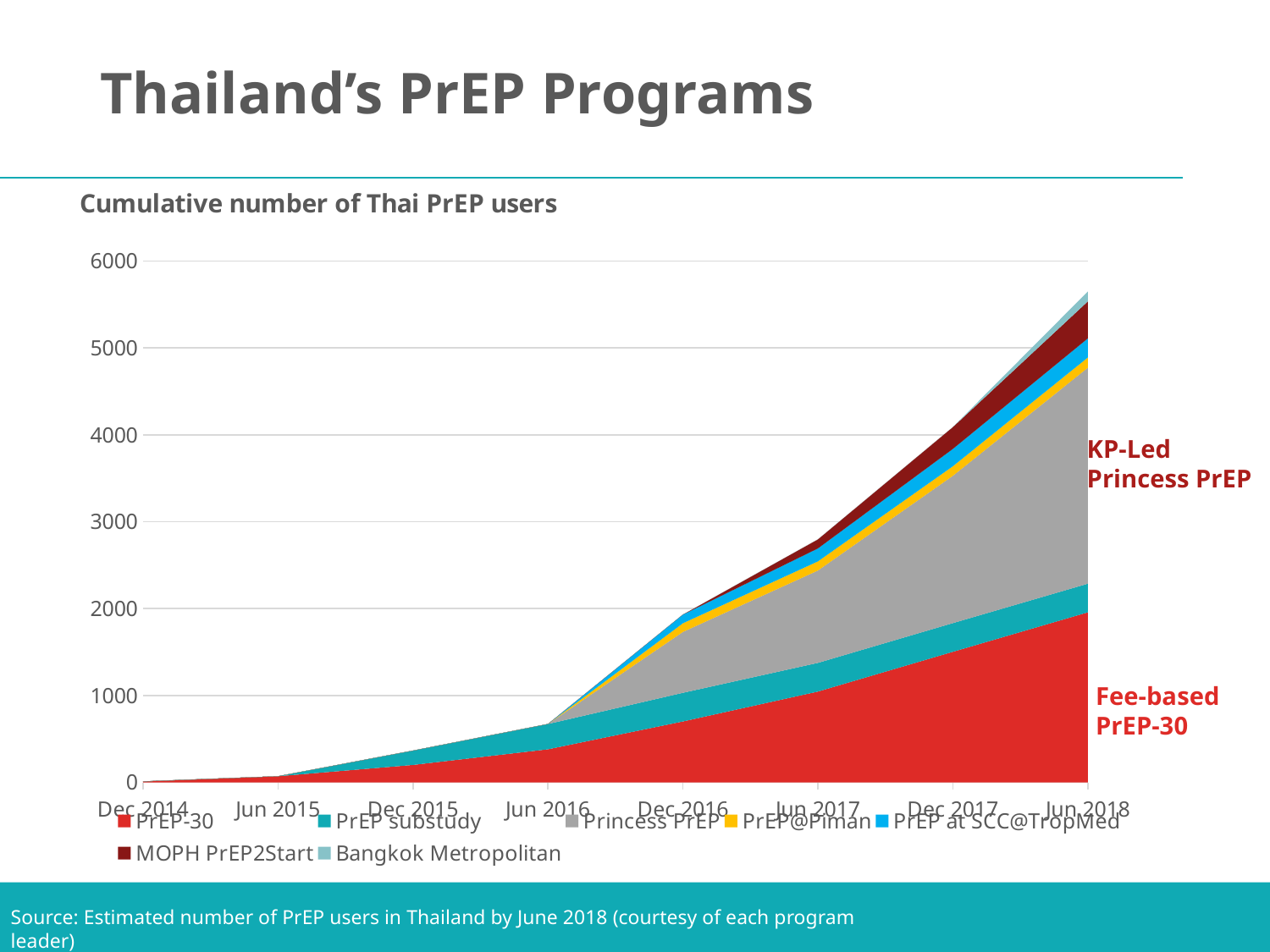
Is the total cumulative number of PrEP users at Jun 2017 greater or less than 3000? less Is the total cumulative number of PrEP users at Jun 2016 greater or less than 1000? less Does the cumulative number of Thai PrEP users rise or fall from Dec 2014 to Jun 2018? Rise How many series does the legend list? 7 How many time points are labelled on the x axis? 8 At Jun 2018, which series contributes more users: Princess PrEP or PrEP-30? Princess PrEP What is the highest value shown on the y axis? 6000 What kind of chart is shown on the slide? Stacked area chart Is the total cumulative number of PrEP users at Jun 2018 greater or less than 5000? greater What is the title of the chart? Cumulative number of Thai PrEP users Which series is labelled on the chart as 'Fee-based'? PrEP-30